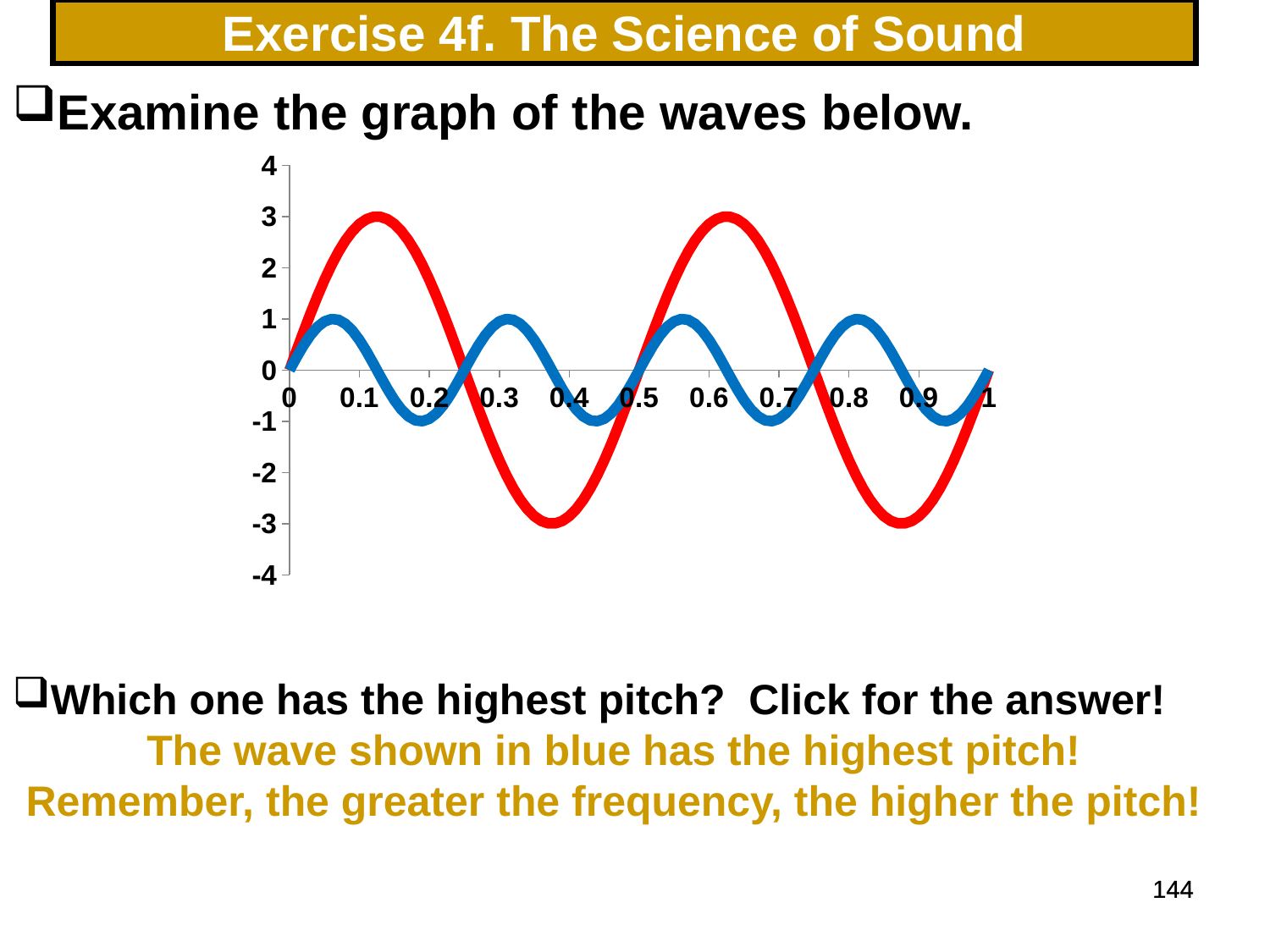
Is the peak value of the red wave greater or less than 2? greater Is the peak value of the blue wave greater or less than 2? less How many peaks does the red wave have between 0 and 1 on the x axis? 2 Which wave reaches a higher peak value, the red wave or the blue wave? red wave How many waves (lines) are plotted on the chart? 2 What is the lowest value reached by the red wave? -3 What are the minimum and maximum values shown on the vertical axis? -4 and 4 What kind of chart is shown on the slide? line chart What is the lowest value reached by the blue wave? -1 What is the highest value reached by the blue wave? 1 How many peaks does the blue wave have between 0 and 1 on the x axis? 4 What is the highest value reached by the red wave? 3